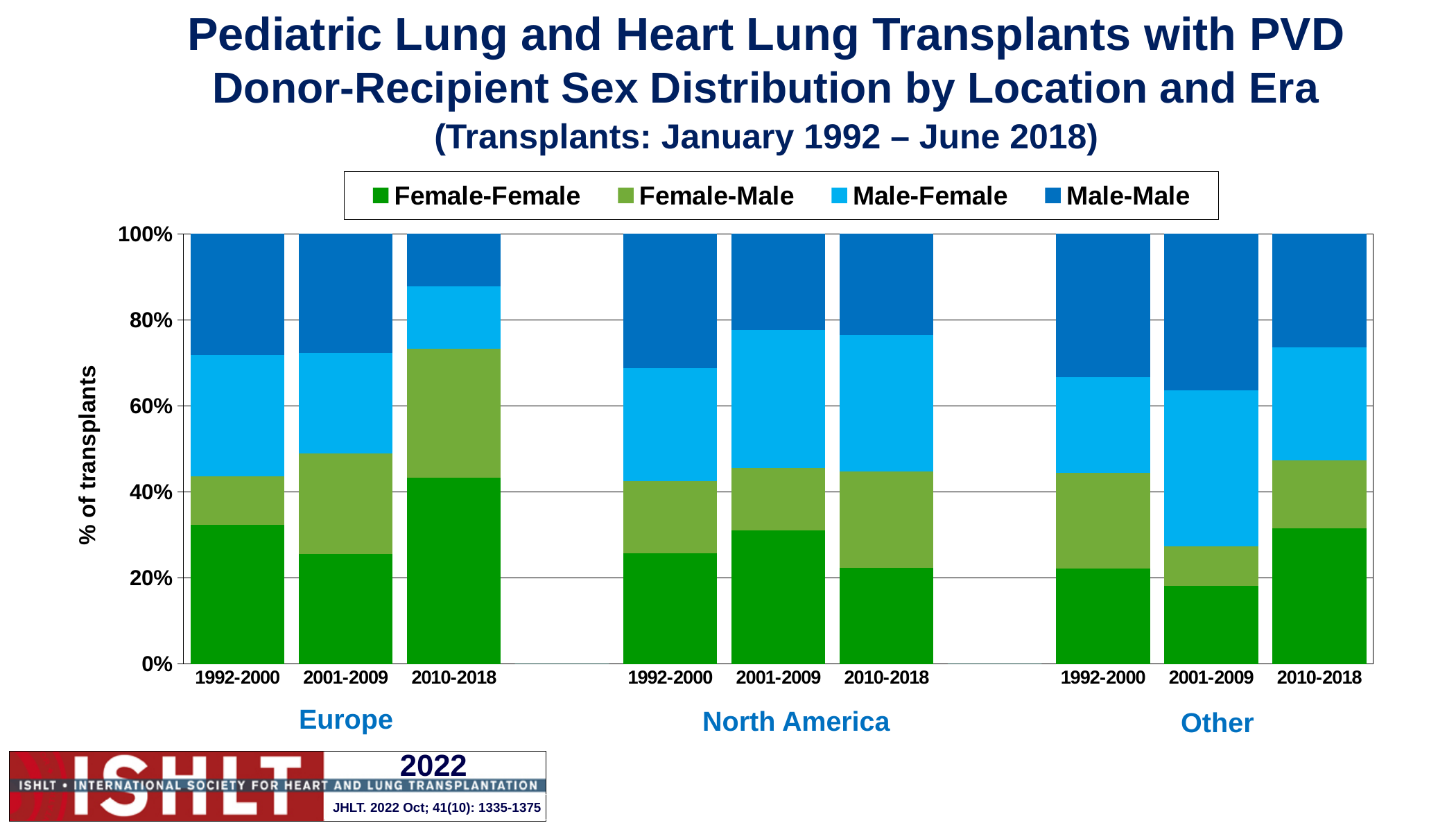
Is the Male-Male share for Europe 2010-2018 greater or less than 20%? less What kind of chart is shown on the slide? Stacked bar chart Which has the larger Female-Female share: Europe 1992-2000 or Europe 2001-2009? Europe 1992-2000 Which bar has the smallest Female-Female share? Other 2001-2009 Which bar has the largest Female-Female share? Europe 2010-2018 What is the label on the y axis? % of transplants How many location groups are shown along the x axis? 3 Is the Female-Female share for Europe 2010-2018 greater or less than 40%? greater How many series does the legend list? 4 Is the Female-Female share for Other 2001-2009 greater or less than 20%? less How many bars are plotted in the chart? 9 Which colour represents Female-Female in the legend? Green